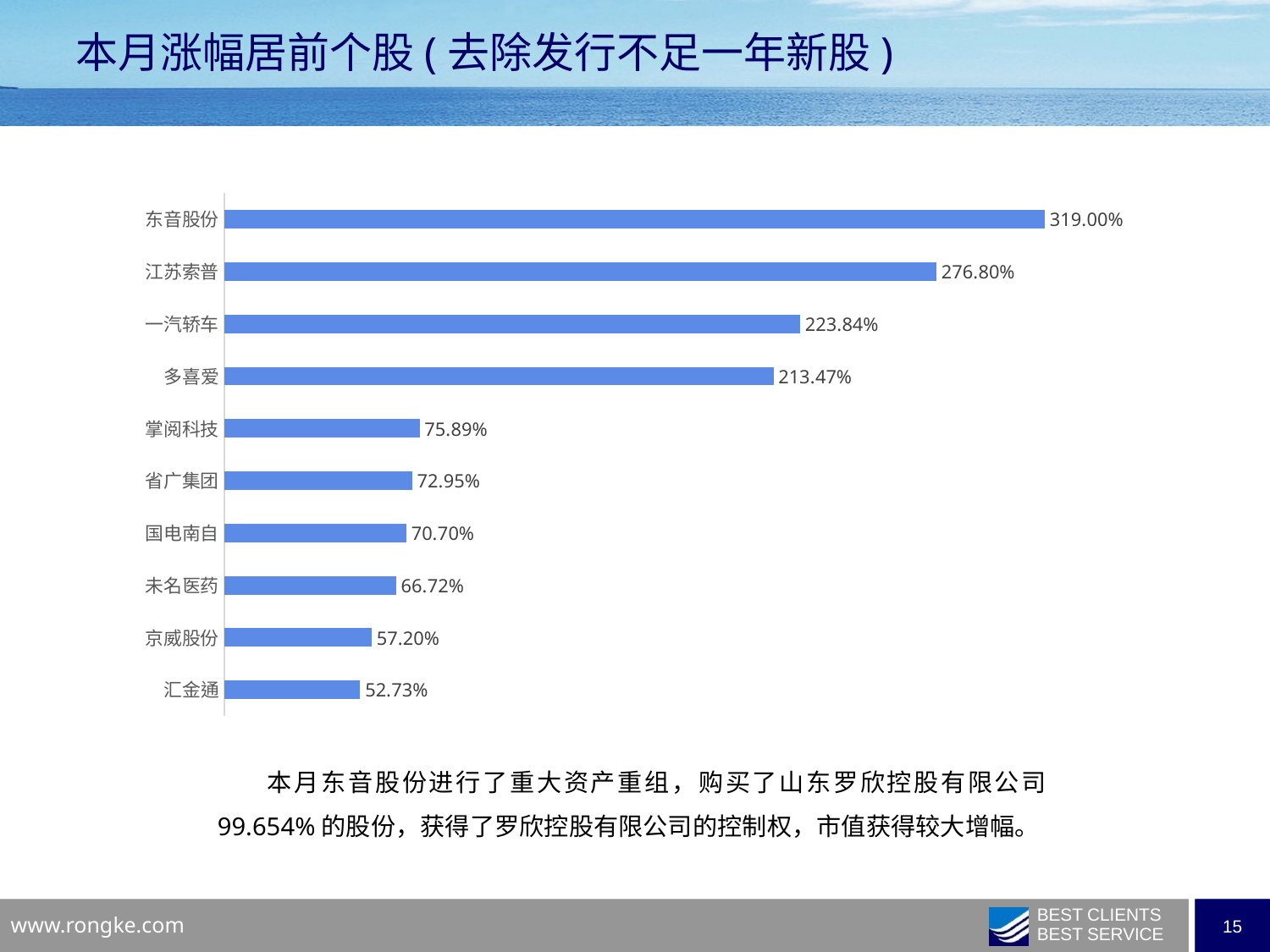
Which is larger, the value for 省广集团 or the value for 未名医药? 省广集团 What is the value for 京威股份? 57.20% What kind of chart is shown on the slide? Bar chart Which stock has the highest value? 东音股份 What is the difference between the values for 多喜爱 and 掌阅科技? 137.58% What is the difference between the values for 东音股份 and 江苏索普? 42.20% What is the value for 国电南自? 70.70% What colour are the bars in the chart? Blue How many stocks are shown in the chart? 10 What is the value for 一汽轿车? 223.84% Which stock has the lowest value? 汇金通 What is the value for 东音股份? 319.00%